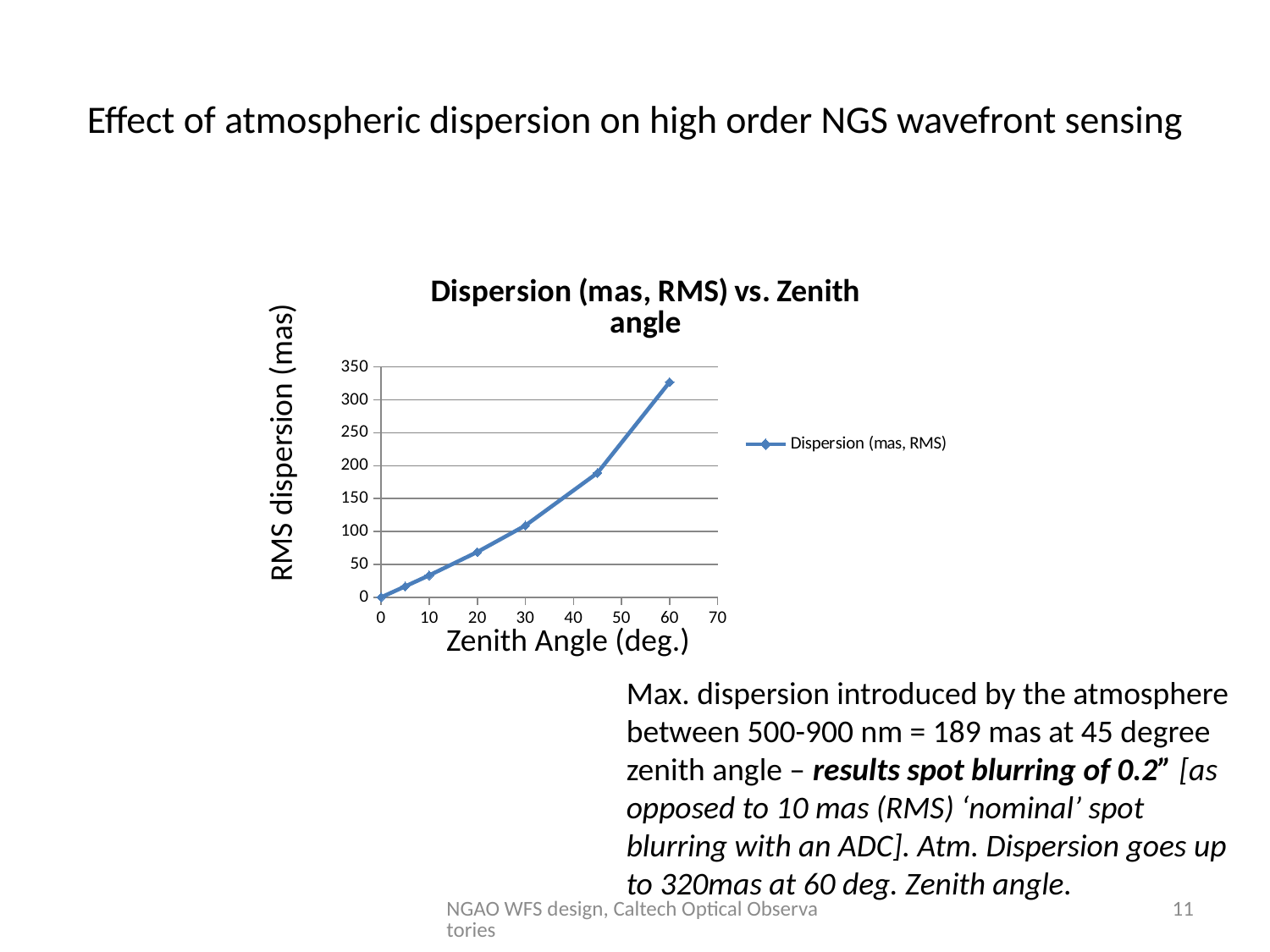
What is the label of the x axis of the chart? Zenith Angle (deg.) At which zenith angle is the plotted dispersion lowest? 0 What is the title of the chart? Dispersion (mas, RMS) vs. Zenith angle What is the dispersion value at a zenith angle of 0 degrees? 0 Is the dispersion value at a zenith angle of 60 degrees greater or less than 300? greater How many data points are plotted on the chart? 7 Does the dispersion rise or fall as the zenith angle increases? rises What kind of chart is shown on the slide? line chart Which has the larger dispersion value: a zenith angle of 45 degrees or 30 degrees? 45 degrees Is the dispersion value at a zenith angle of 10 degrees greater or less than 50? less At which zenith angle is the plotted dispersion highest? 60 How many series does the chart legend list? 1